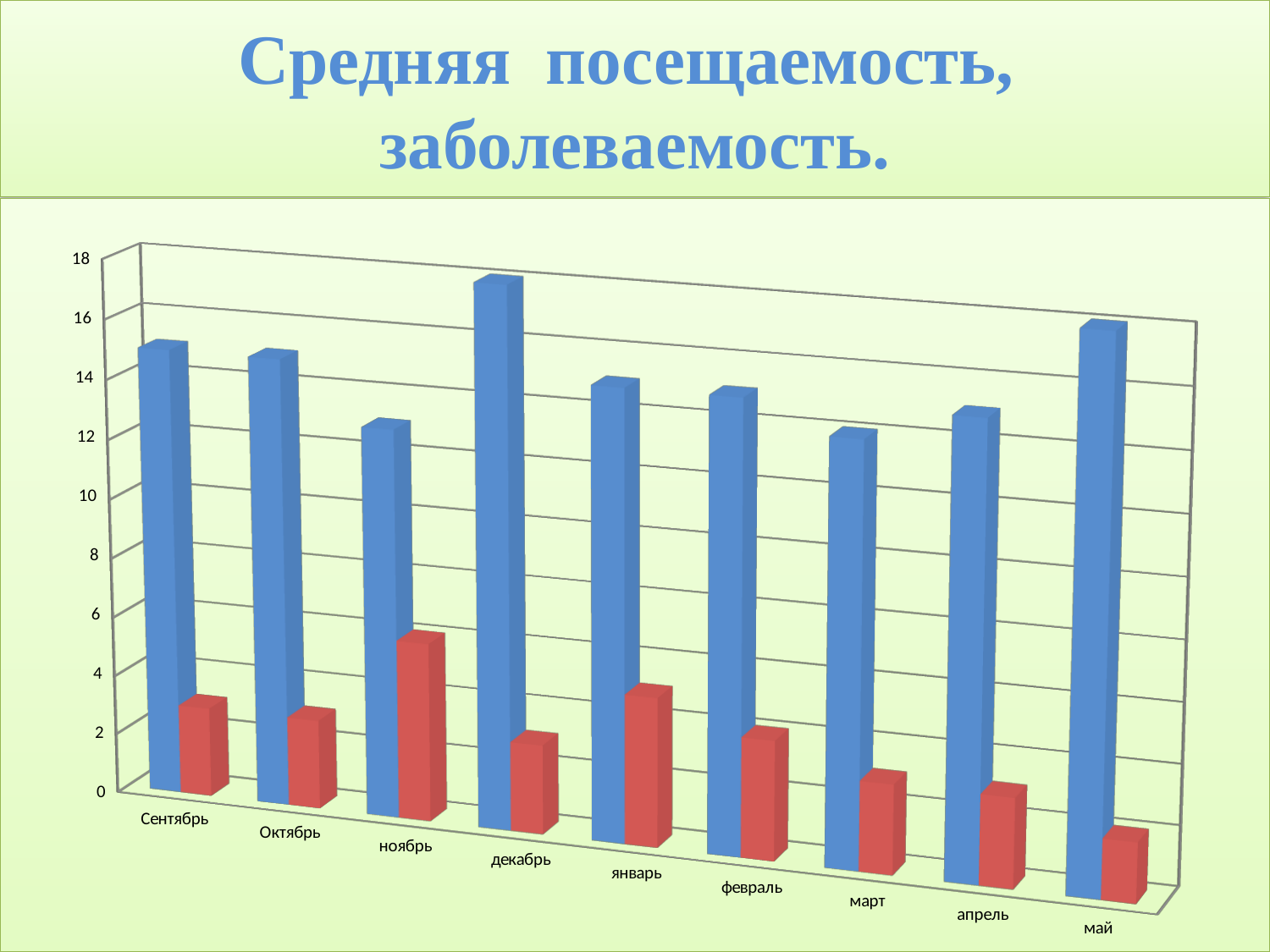
Is the red bar for май greater or less than 2? less How many bars are plotted for each month in the chart? 2 What is the title of the slide containing the chart? Средняя посещаемость, заболеваемость. How many months (categories) are shown on the x axis of the chart? 9 Which is taller, the blue bar for декабрь or the blue bar for март? декабрь Is the red bar for ноябрь greater or less than 4? greater What two colours are used for the bars in the chart? blue and red In which month is the red bar the tallest? ноябрь In which month is the blue bar the tallest? декабрь Is the blue bar for ноябрь greater or less than 14? less What kind of chart is shown on the slide? bar chart